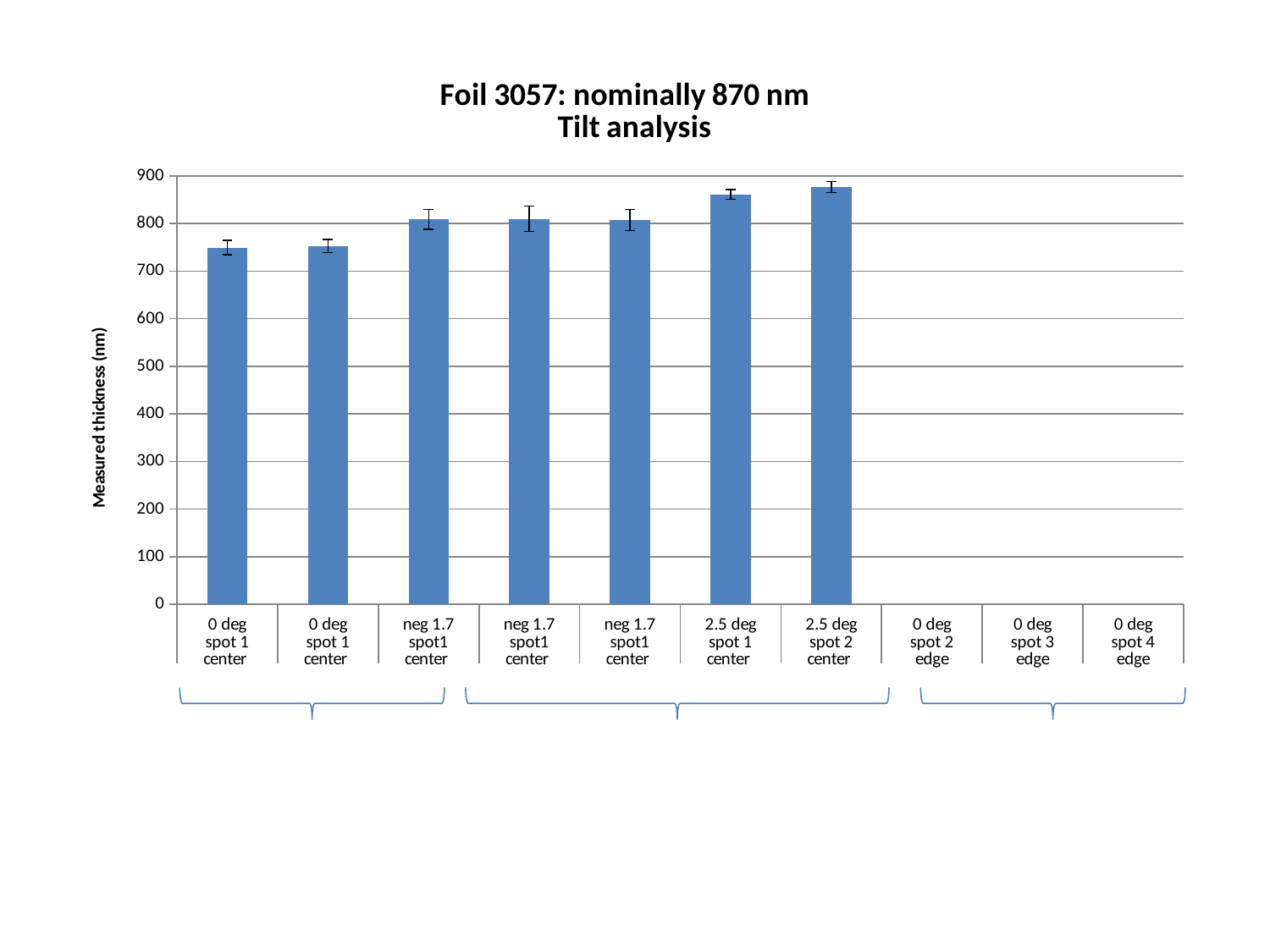
Which is larger, the value for '2.5 deg spot 1 center' or the first '0 deg spot 1 center' bar? 2.5 deg spot 1 center Is the value for '2.5 deg spot 1 center' greater or less than 800? greater Is the value for the first 'neg 1.7 spot1 center' bar greater or less than 700? greater What kind of chart is shown on the slide? bar chart Which category has the tallest bar? 2.5 deg spot 2 center What is the title of the chart? Foil 3057: nominally 870 nm Tilt analysis How many categories are listed along the x axis? 10 Is the value for '2.5 deg spot 2 center' greater or less than 900? less What is the label of the vertical axis? Measured thickness (nm) Which is larger, the value for '2.5 deg spot 2 center' or the second 'neg 1.7 spot1 center' bar? 2.5 deg spot 2 center